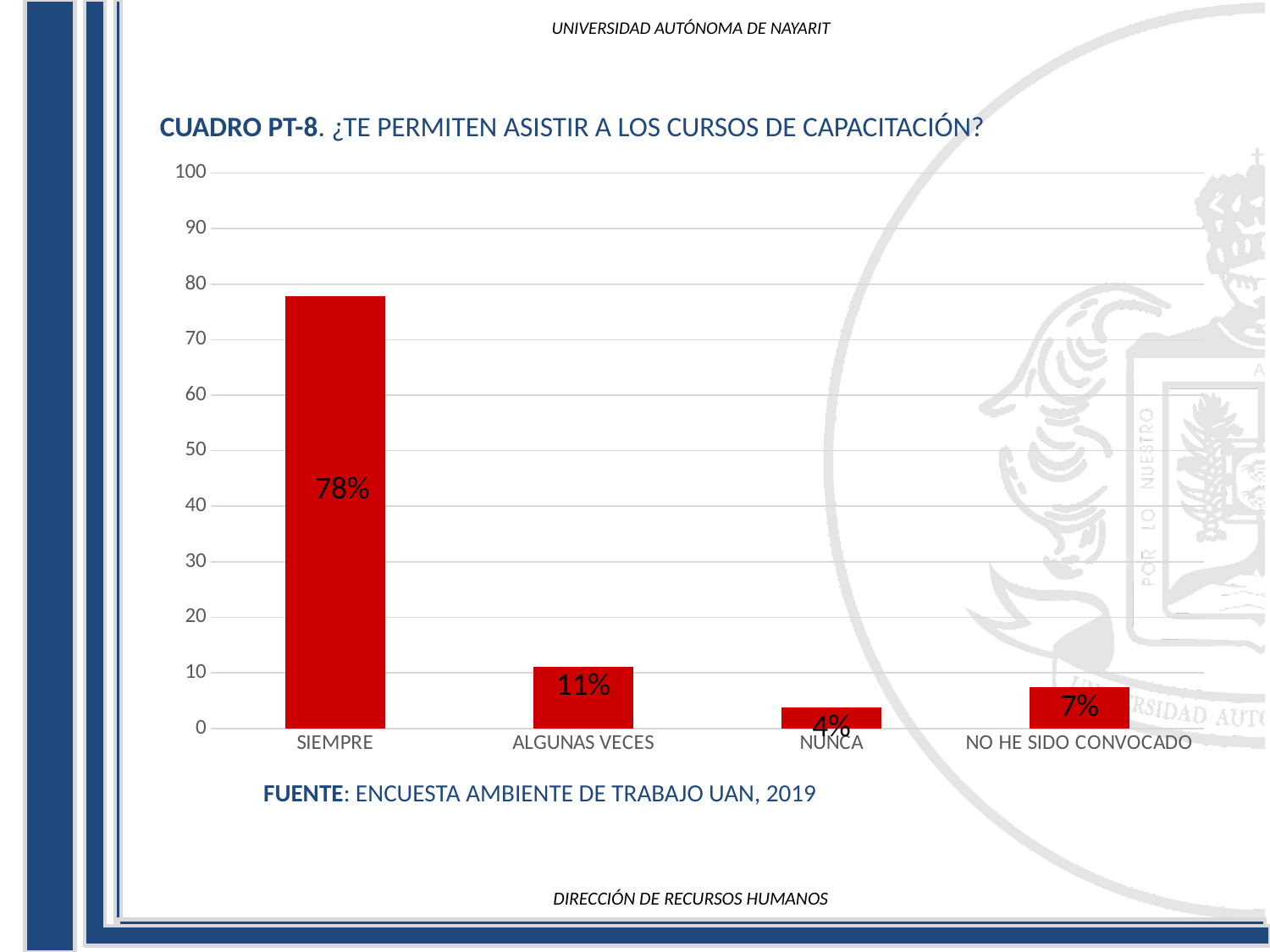
How many categories are shown on the x axis? 4 What is the value for SIEMPRE? 78% Which category has the highest value? SIEMPRE What is the value for NO HE SIDO CONVOCADO? 7% What is the source cited below the chart? ENCUESTA AMBIENTE DE TRABAJO UAN, 2019 What is the value for ALGUNAS VECES? 11% What kind of chart is shown on the slide? bar chart Is the value for SIEMPRE greater or less than 70? greater What is the difference between the values for SIEMPRE and ALGUNAS VECES? 67% Which category has the lowest value? NUNCA Which is larger, the value for NO HE SIDO CONVOCADO or the value for NUNCA? NO HE SIDO CONVOCADO What is the value for NUNCA? 4%